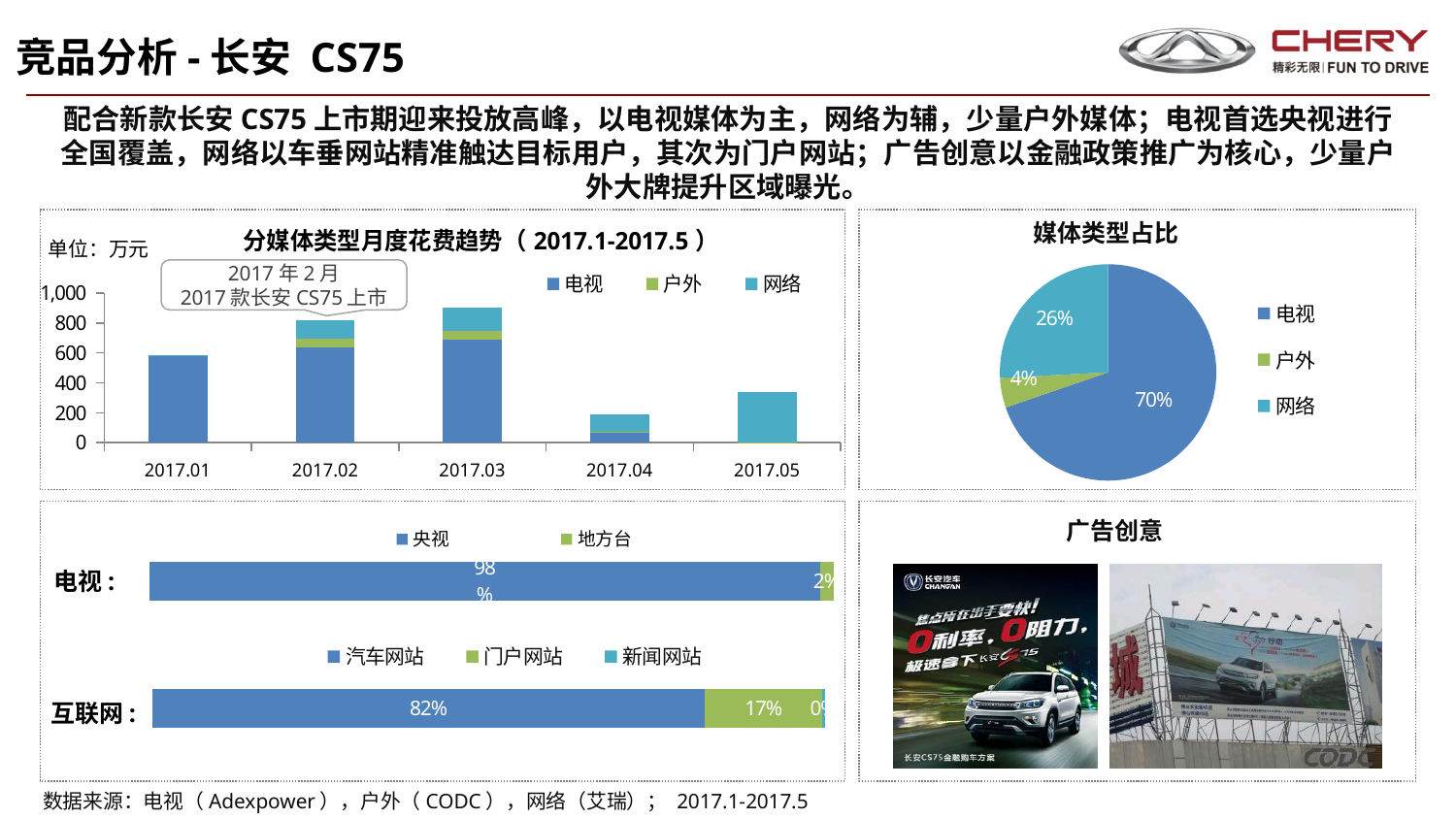
In the horizontal bar for 互联网 in the lower-left panel, what share does 门户网站 account for? 17% In the chart titled 分媒体类型月度花费趋势（2017.1-2017.5）, is the total for 2017.03 greater or less than 800? greater In the chart titled 分媒体类型月度花费趋势（2017.1-2017.5）, which month has the highest total spending? 2017.03 In the pie chart titled 媒体类型占比, what share does 网络 have? 26% In the chart titled 分媒体类型月度花费趋势（2017.1-2017.5）, how many series does the legend list? 3 In the chart titled 分媒体类型月度花费趋势（2017.1-2017.5）, which month has the lowest total spending? 2017.04 In the horizontal bar for 电视 in the lower-left panel, what share does 央视 account for? 98% In the chart titled 分媒体类型月度花费趋势（2017.1-2017.5）, how many months are shown on the x axis? 5 In the pie chart titled 媒体类型占比, which media type has the smallest share? 户外 In the pie chart titled 媒体类型占比, what share does 电视 have? 70% In the pie chart titled 媒体类型占比, how many percentage points larger is the 电视 share than the 网络 share? 44 In the chart titled 分媒体类型月度花费趋势（2017.1-2017.5）, is the total for 2017.05 greater or less than 400? less